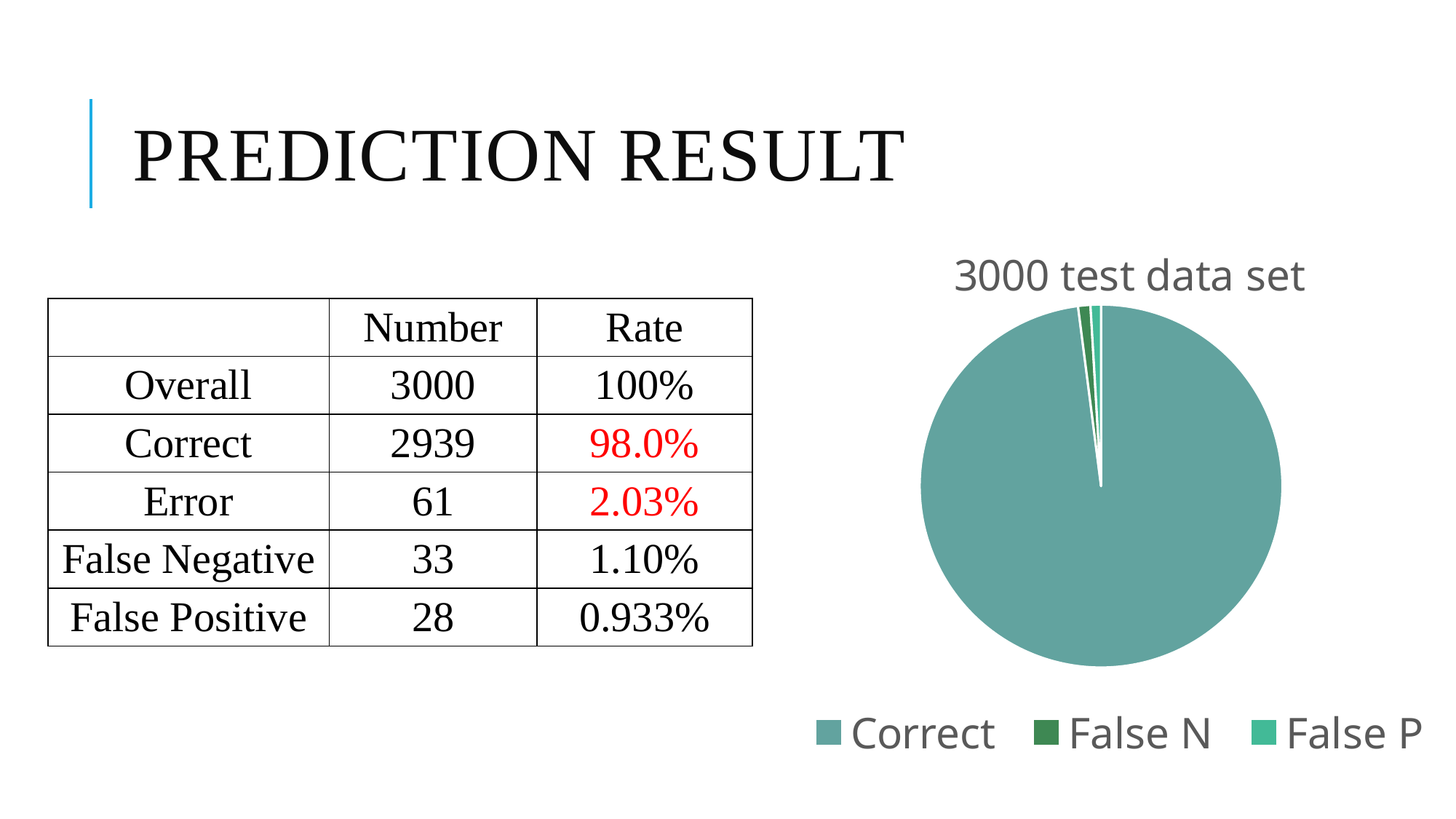
Which slice of the pie chart is the largest? Correct How many entries does the pie chart's legend list? 3 Which is larger in the pie chart, the Correct slice or the False N slice? Correct What are the three legend entries of the pie chart, in order? Correct, False N, False P Which is larger in the pie chart, the False P slice or the Correct slice? Correct What is the title of the pie chart? 3000 test data set How many slices does the pie chart have? 3 What kind of chart is shown on the slide? pie chart